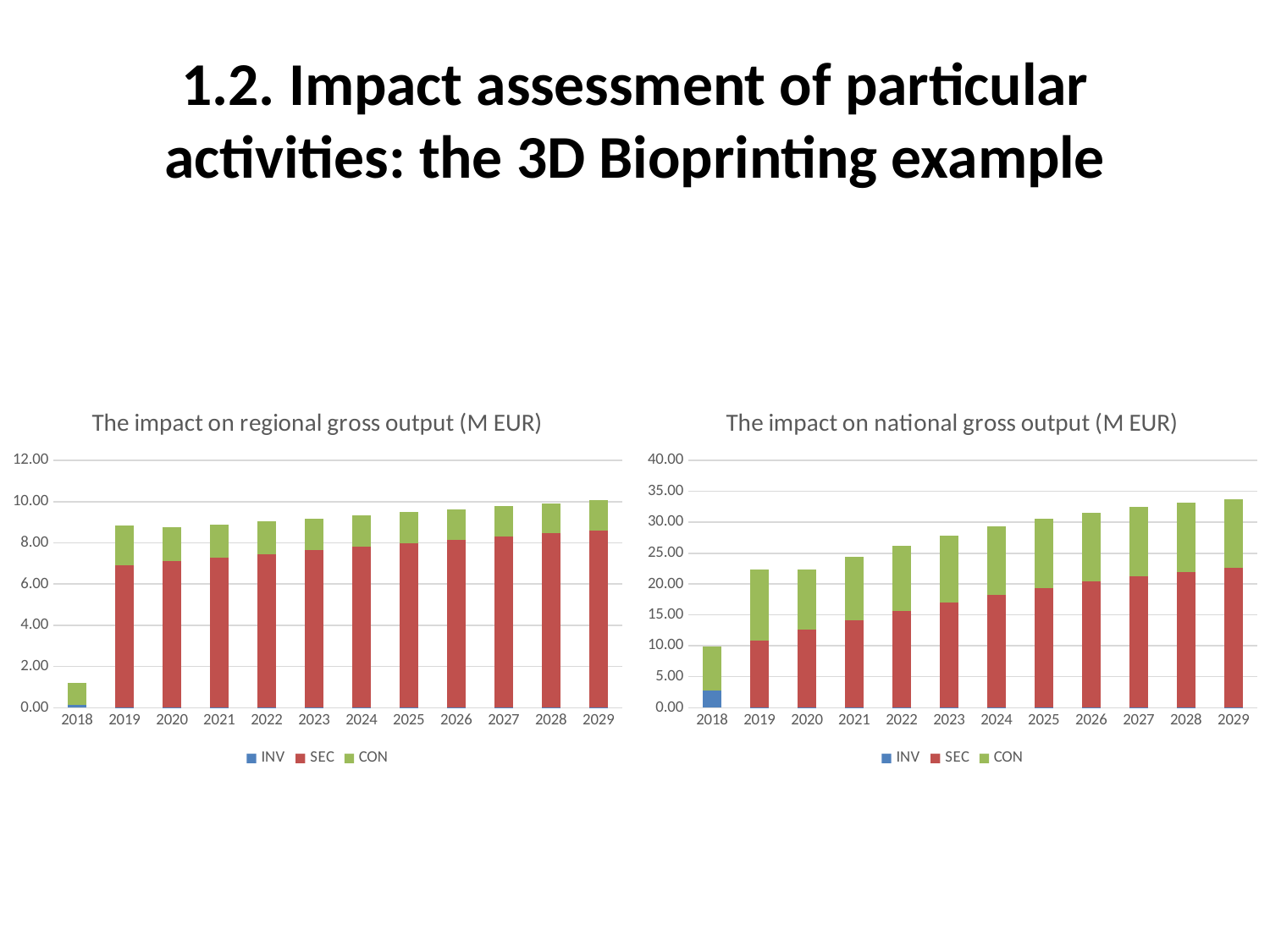
In 'The impact on regional gross output (M EUR)', is the total for 2019 greater or less than 8.00? greater In 'The impact on national gross output (M EUR)', which year has the lowest total bar? 2018 How many years are shown on the x axis of 'The impact on regional gross output (M EUR)'? 12 In 'The impact on national gross output (M EUR)', do the total bars rise or fall from 2019 to 2029? rise Which series is shown in green in both charts? CON How many series does the legend list in 'The impact on national gross output (M EUR)'? 3 In 'The impact on national gross output (M EUR)', which total is larger, 2020 or 2025? 2025 In 'The impact on national gross output (M EUR)', is the total for 2018 greater or less than 15.00? less In 'The impact on national gross output (M EUR)', is the total for 2029 greater or less than 30.00? greater What kind of chart is 'The impact on regional gross output (M EUR)'? stacked bar chart In 'The impact on regional gross output (M EUR)', which year has the highest total bar? 2029